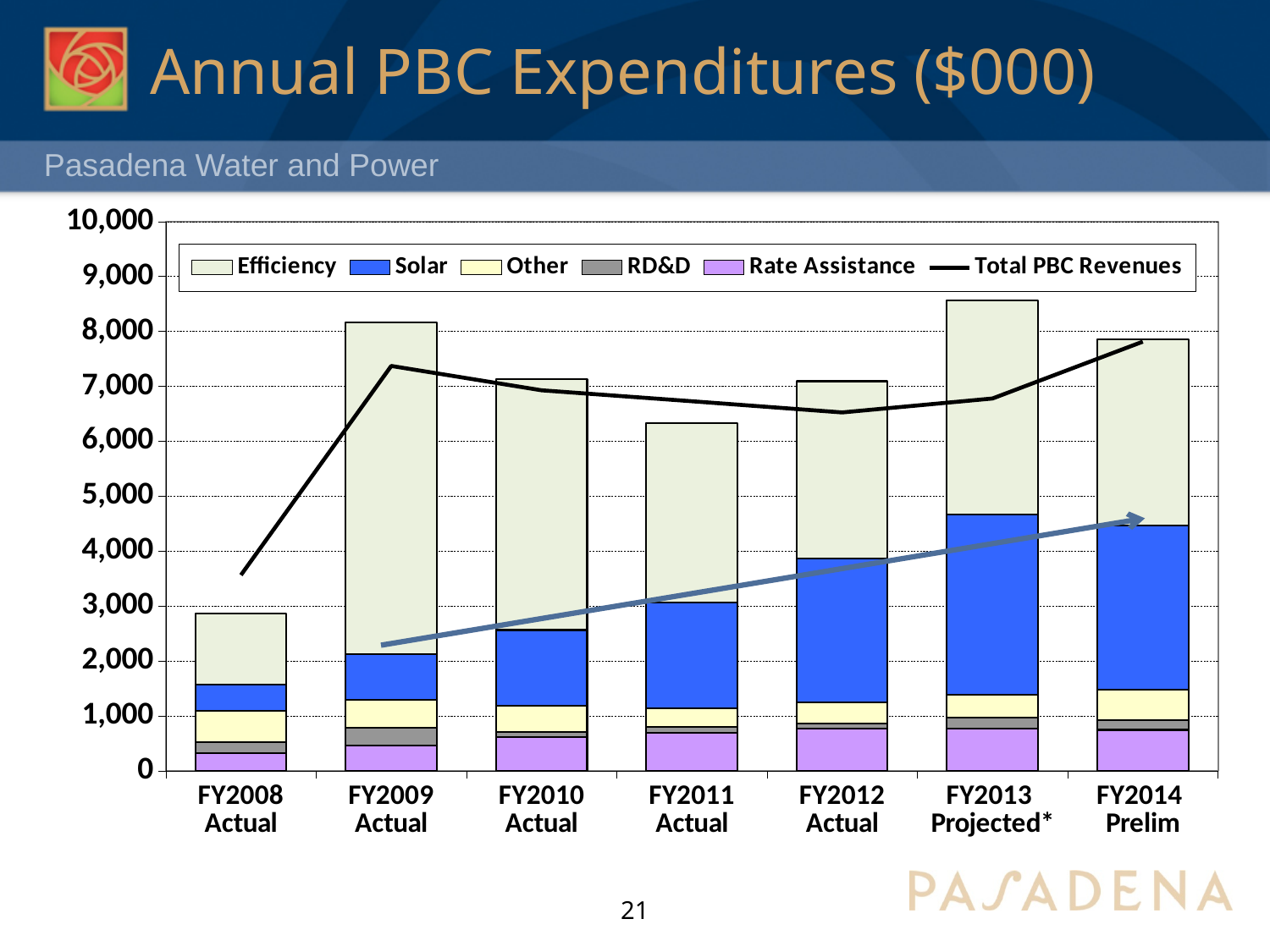
How many fiscal year categories are shown on the x axis? 7 Which fiscal year has the shortest stacked bar of expenditures? FY2008 Actual What is the title of the chart on the slide? Annual PBC Expenditures ($000) Which fiscal year has the tallest stacked bar of expenditures? FY2013 Projected* How many series does the legend list? 6 Is the total expenditure bar for FY2011 Actual greater or less than 6,000? greater Is the Total PBC Revenues value for FY2008 Actual greater or less than 3,000? greater Does the Total PBC Revenues line rise or fall from FY2008 Actual to FY2009 Actual? rise What kind of chart is shown on the slide? Stacked bar chart with a line Is the total expenditure bar for FY2009 Actual greater or less than 8,000? greater Which has the larger total expenditure bar, FY2010 Actual or FY2011 Actual? FY2010 Actual